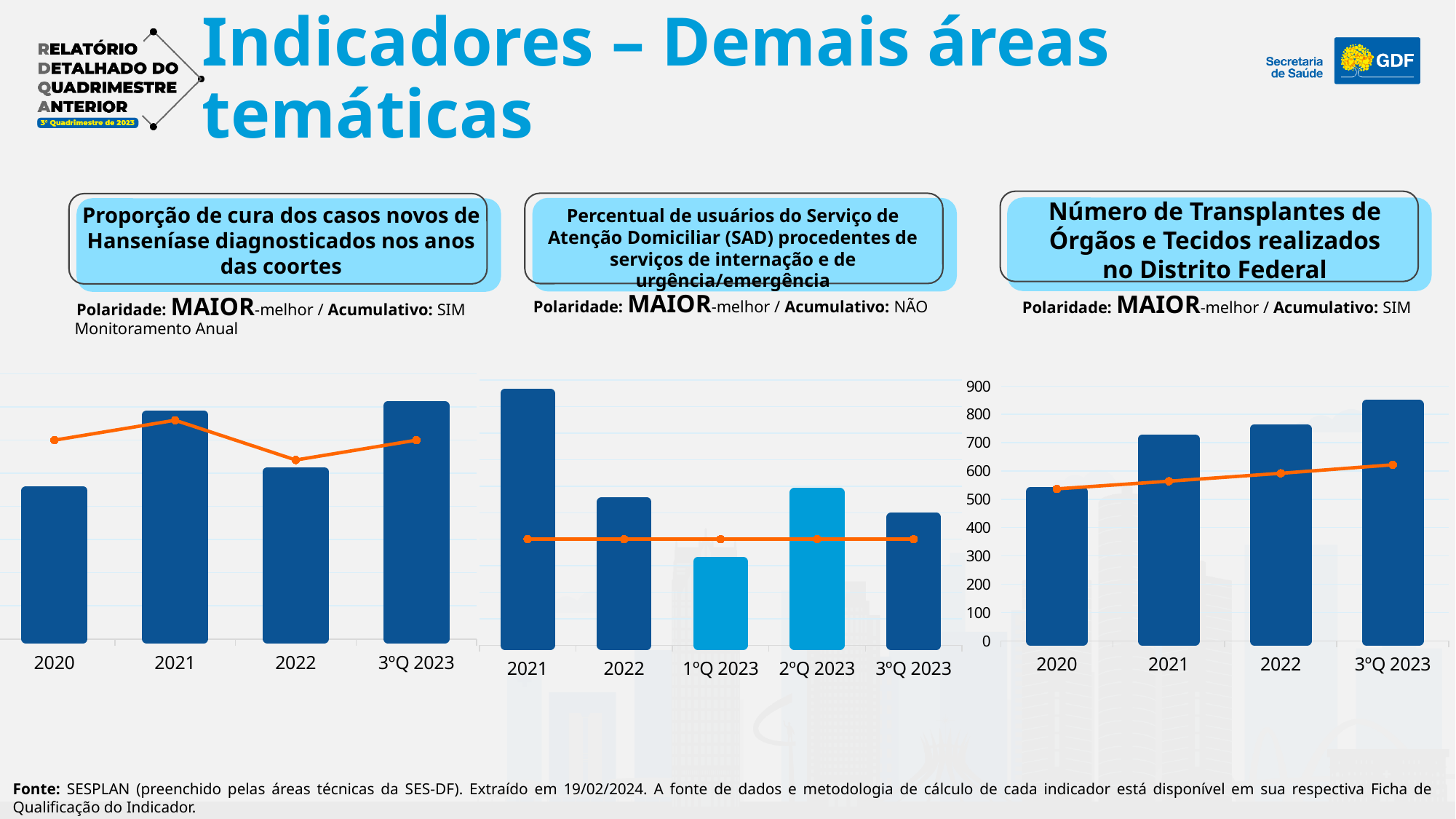
On the chart 'Número de Transplantes de Órgãos e Tecidos realizados no Distrito Federal', do the bar values rise or fall from 2020 to 3ºQ 2023? rise How many categories are shown on the x axis of the chart 'Proporção de cura dos casos novos de Hanseníase'? 4 On the chart 'Número de Transplantes de Órgãos e Tecidos realizados no Distrito Federal', which category has the lowest bar? 2020 On the chart 'Número de Transplantes de Órgãos e Tecidos realizados no Distrito Federal', is the bar for 2020 greater or less than 500? greater On the chart 'Percentual de usuários do Serviço de Atenção Domiciliar (SAD)', which category has the lowest bar? 1ºQ 2023 What kind of chart is the 'Proporção de cura dos casos novos de Hanseníase' chart? bar chart with a line On the chart 'Número de Transplantes de Órgãos e Tecidos realizados no Distrito Federal', is the bar for 2021 greater or less than 800? less On the chart 'Número de Transplantes de Órgãos e Tecidos realizados no Distrito Federal', which category has the highest bar? 3ºQ 2023 On the chart 'Número de Transplantes de Órgãos e Tecidos realizados no Distrito Federal', is the bar for 3ºQ 2023 greater or less than 800? greater On the chart 'Percentual de usuários do Serviço de Atenção Domiciliar (SAD)', which category has the highest bar? 2021 On the chart 'Proporção de cura dos casos novos de Hanseníase', which category has the lowest bar? 2020 How many categories are shown on the x axis of the chart 'Percentual de usuários do Serviço de Atenção Domiciliar (SAD)'? 5